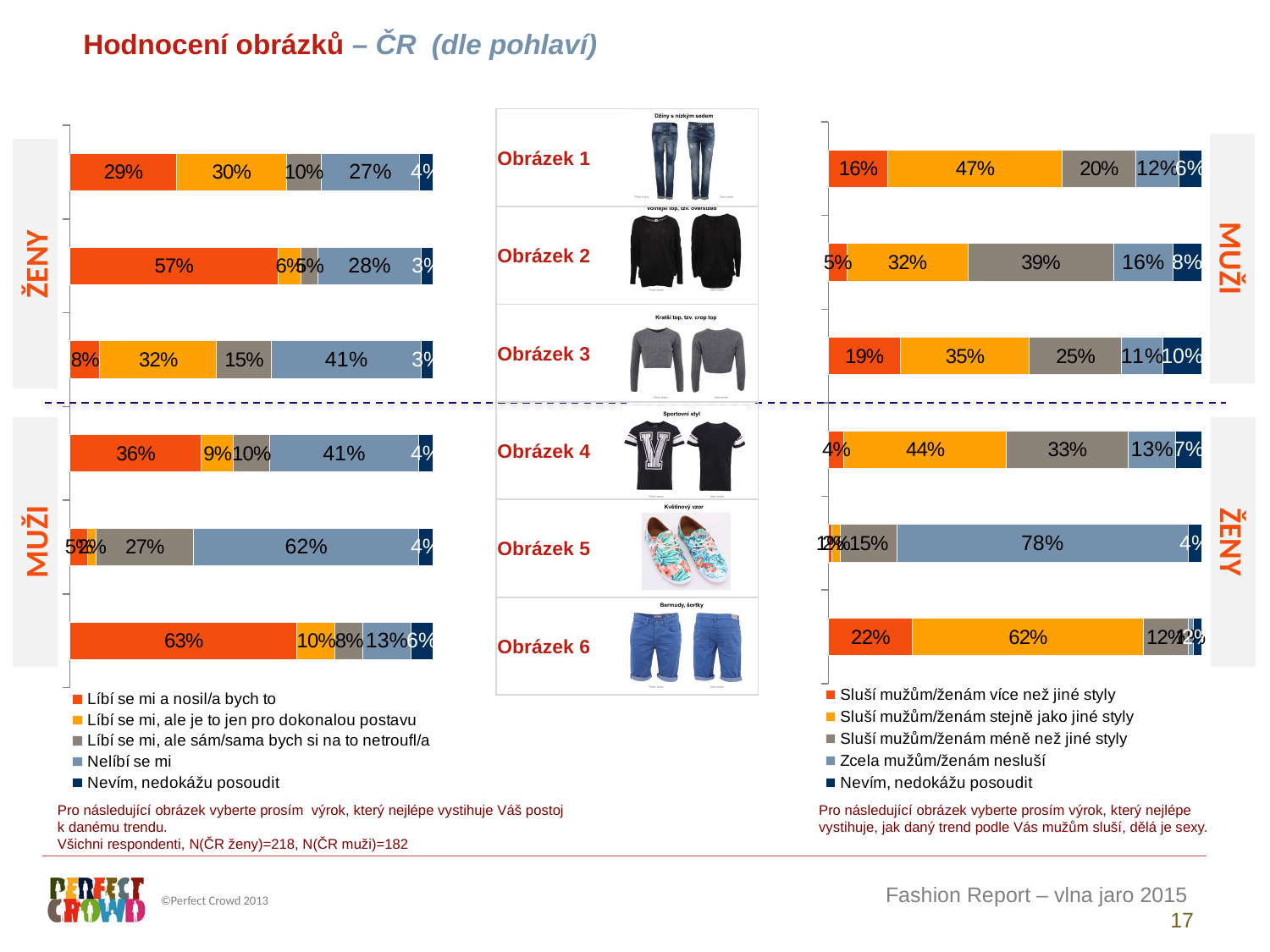
In the left chart, what percentage of women chose "Nelíbí se mi" for Obrázek 3? 41% In the left chart, which picture has the highest share of men choosing "Líbí se mi a nosil/a bych to"? Obrázek 6 In the left chart, what percentage of women chose "Líbí se mi a nosil/a bych to" for Obrázek 2? 57% In the right chart, which is larger for Obrázek 3 among men: "Sluší mužům/ženám více než jiné styly" or "Sluší mužům/ženám stejně jako jiné styly"? Sluší mužům/ženám stejně jako jiné styly What type of chart is used on the left side of the slide? Stacked bar chart In the left chart, what percentage of men chose "Nelíbí se mi" for Obrázek 5? 62% In the right chart, which picture has the highest share of men choosing "Sluší mužům/ženám méně než jiné styly"? Obrázek 2 How many series does the legend of the left chart list? 5 In the right chart, what percentage of women chose "Zcela mužům/ženám nesluší" for Obrázek 5? 78% How many bars (pictures) are shown in the right chart? 6 In the right chart, what percentage of men chose "Sluší mužům/ženám stejně jako jiné styly" for Obrázek 1? 47% In the left chart, what is the difference between the "Líbí se mi a nosil/a bych to" share for Obrázek 2 among women (57%) and for Obrázek 1 among women (29%)? 28 percentage points